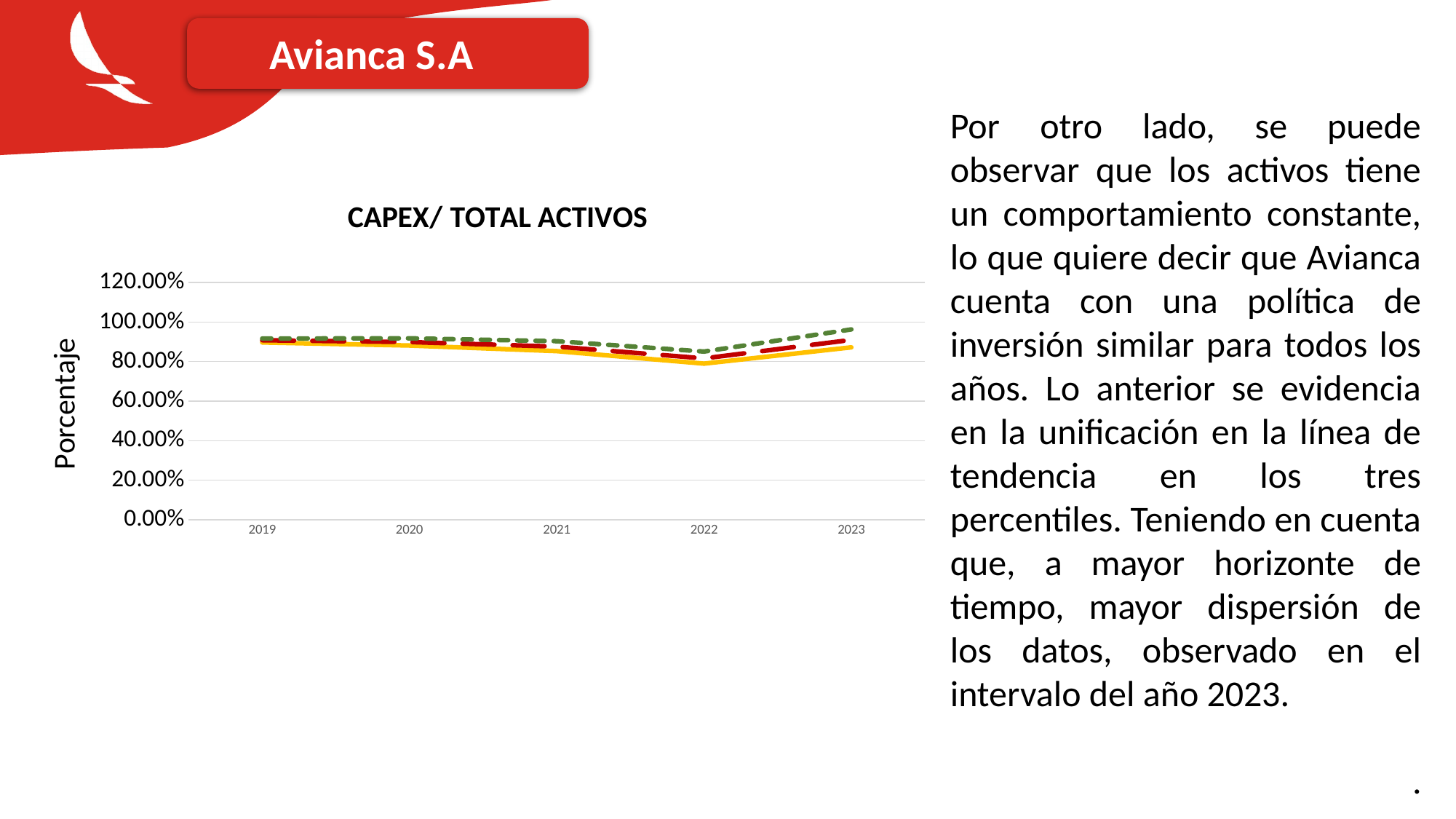
Do the lines rise or fall between 2022 and 2023? rise What is the title of the chart? CAPEX/ TOTAL ACTIVOS Is the value of the green dashed line in 2023 greater or less than 100.00%? less Is the value of the green dashed line in 2019 greater or less than 80.00%? greater How many years are shown on the x axis of the chart? 5 Is the value of the yellow line in 2022 greater or less than 60.00%? greater What is the label on the vertical axis of the chart? Porcentaje How many lines are plotted on the chart? 3 Which year is the last on the x axis of the chart? 2023 Which year is the first on the x axis of the chart? 2019 What kind of chart is shown on the slide? line chart In which year does the yellow line reach its lowest value? 2022